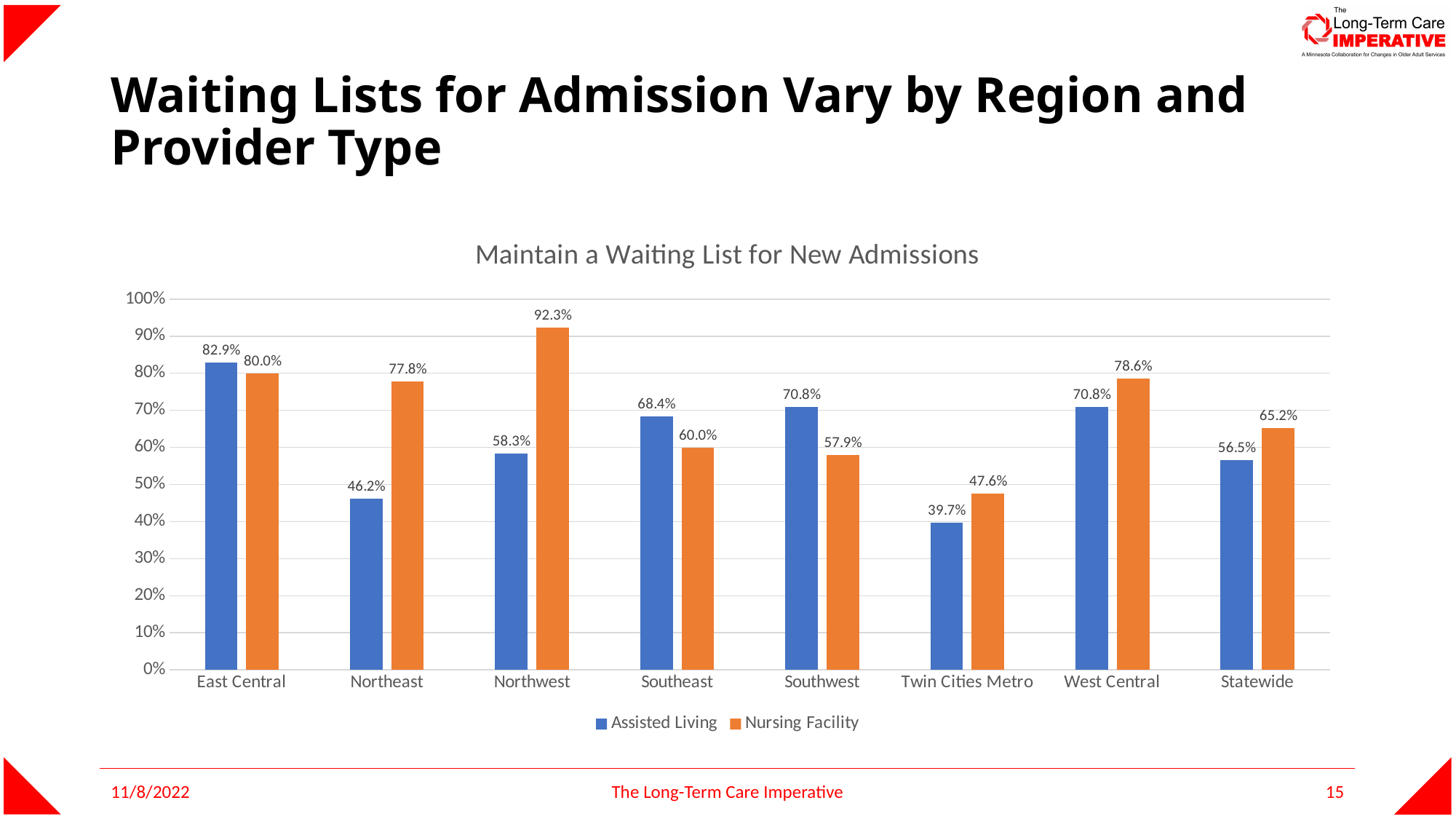
What kind of chart is shown on the slide? Bar chart Which is larger for Southeast: Assisted Living or Nursing Facility? Assisted Living What is the title of the chart? Maintain a Waiting List for New Admissions What is the Nursing Facility value for Twin Cities Metro? 47.6% What is the Statewide value for Assisted Living? 56.5% Which region has the lowest Assisted Living value? Twin Cities Metro Which region has the highest Nursing Facility value? Northwest Is the Nursing Facility value for West Central greater or less than 70%? greater How many categories are shown on the x axis? 8 What is the difference between the Nursing Facility and Assisted Living values for Northeast? 31.6% What is the Assisted Living value for Northwest? 58.3% How many series does the legend list? 2